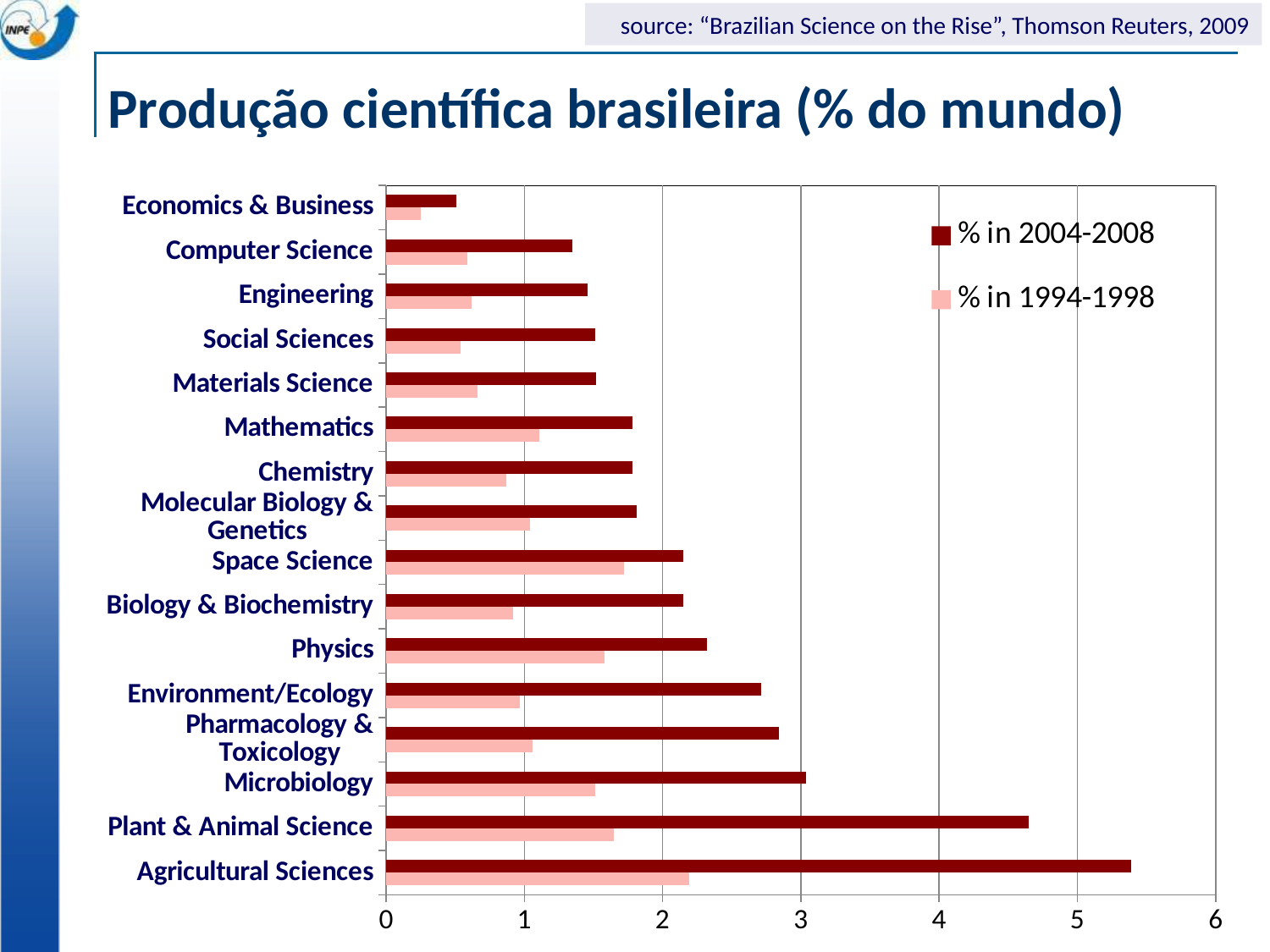
Is the value for Space Science in 1994-1998 greater or less than 1? greater Which is larger for % in 2004-2008: Plant & Animal Science or Microbiology? Plant & Animal Science What kind of chart is shown on the slide? bar chart Which field has the lowest value for % in 2004-2008? Economics & Business Which series is shown in dark red in the legend? % in 2004-2008 Which field has the highest value for % in 1994-1998? Agricultural Sciences Is the value for Plant & Animal Science in 2004-2008 greater or less than 4? greater Is the value for Agricultural Sciences in 2004-2008 greater or less than 5? greater How many series does the legend list? 2 How many research fields (categories) are shown on the chart? 16 Which field has the highest value for % in 2004-2008? Agricultural Sciences